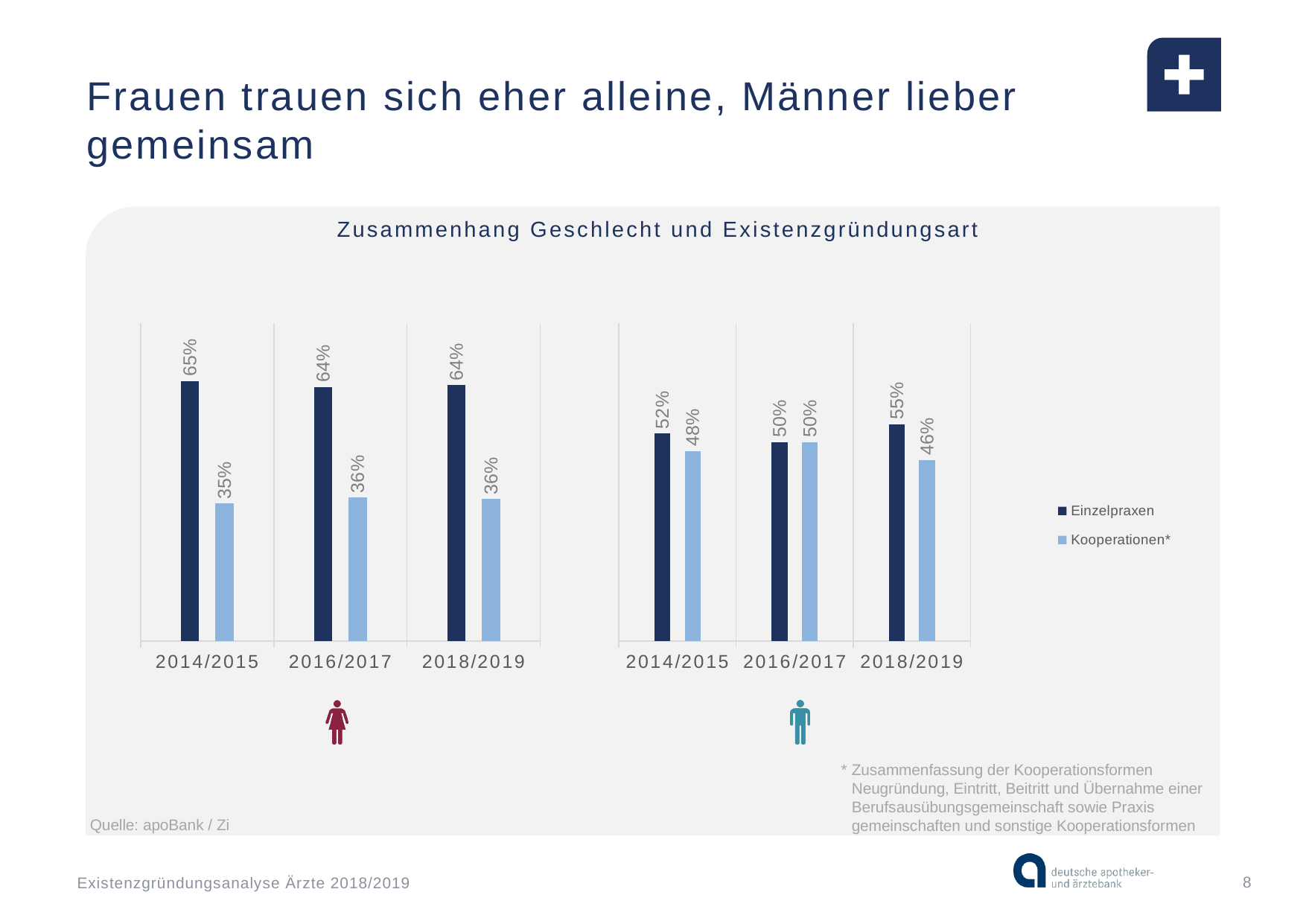
What kind of chart is shown on the slide? Bar chart How many periods are shown on the x axis of the left (women) panel of the chart? 3 In the left (women) panel of the chart, which period has the lowest Kooperationen* value? 2014/2015 How many series does the chart legend list? 2 In the left (women) panel of the chart, what is the difference between Einzelpraxen and Kooperationen* in 2018/2019? 28% In the left (women) panel of the chart, what is the value for Kooperationen* in 2016/2017? 36% In the left (women) panel of the chart, what is the value for Einzelpraxen in 2014/2015? 65% In the right (men) panel of the chart, which is larger in 2014/2015: Einzelpraxen or Kooperationen*? Einzelpraxen In the right (men) panel of the chart, what is the value for Kooperationen* in 2018/2019? 46% In the right (men) panel of the chart, what is the value for Einzelpraxen in 2014/2015? 52% What is the title of the chart? Zusammenhang Geschlecht und Existenzgründungsart In the right (men) panel of the chart, which period has the highest Einzelpraxen value? 2018/2019